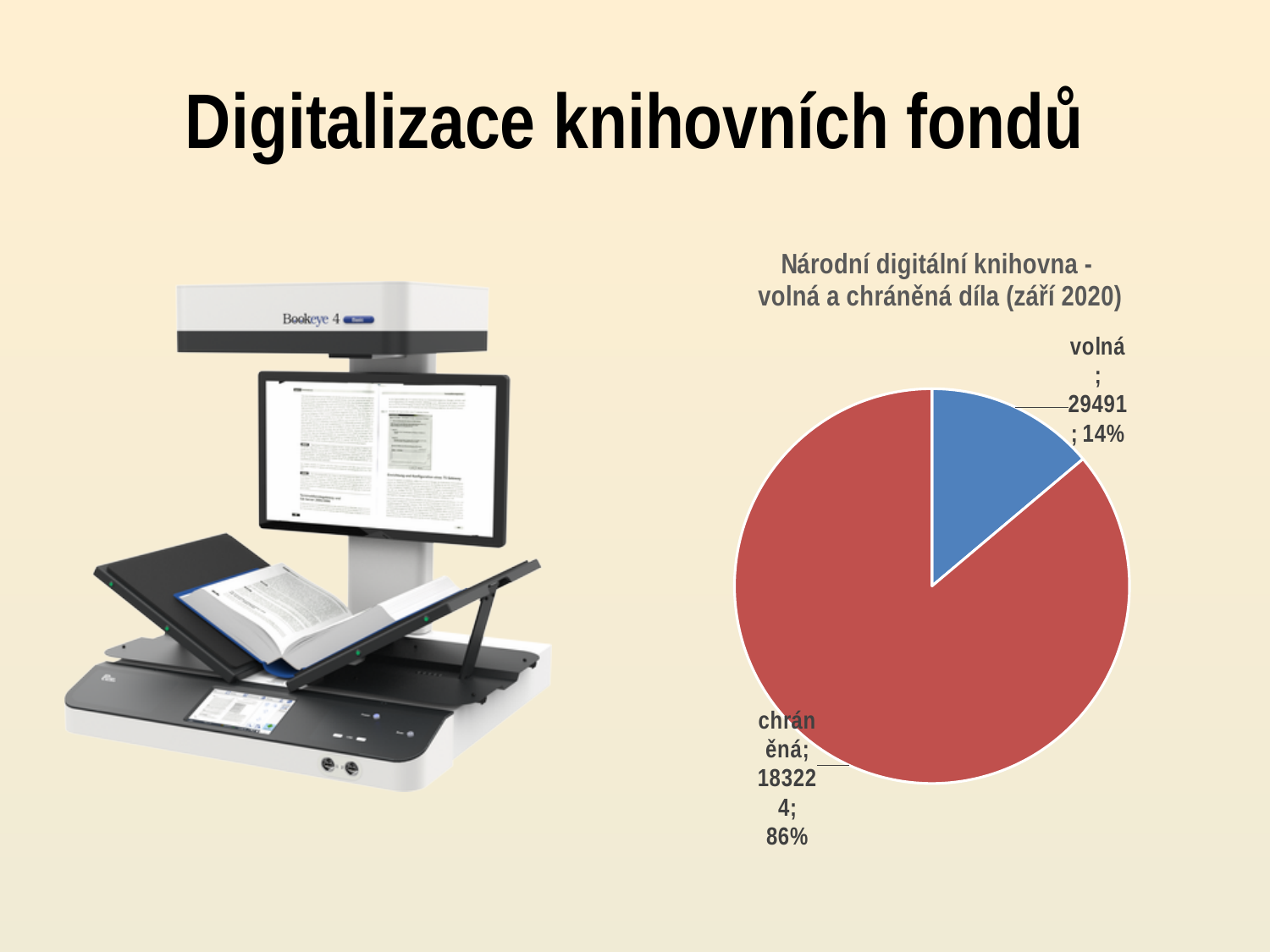
What is the title of the chart? Národní digitální knihovna - volná a chráněná díla (září 2020) What is the difference between the values for chráněná and volná? 153733 What kind of chart is shown on the slide? pie chart Which category has the largest slice in the pie chart? chráněná What share of the pie does the volná slice represent? 14% What is the value for volná in the pie chart? 29491 What colour is the volná slice in the pie chart? blue What is the value for chráněná in the pie chart? 183224 How many slices does the pie chart have? 2 What share of the pie does the chráněná slice represent? 86% Which category has the smallest slice in the pie chart? volná Which is larger, volná or chráněná? chráněná